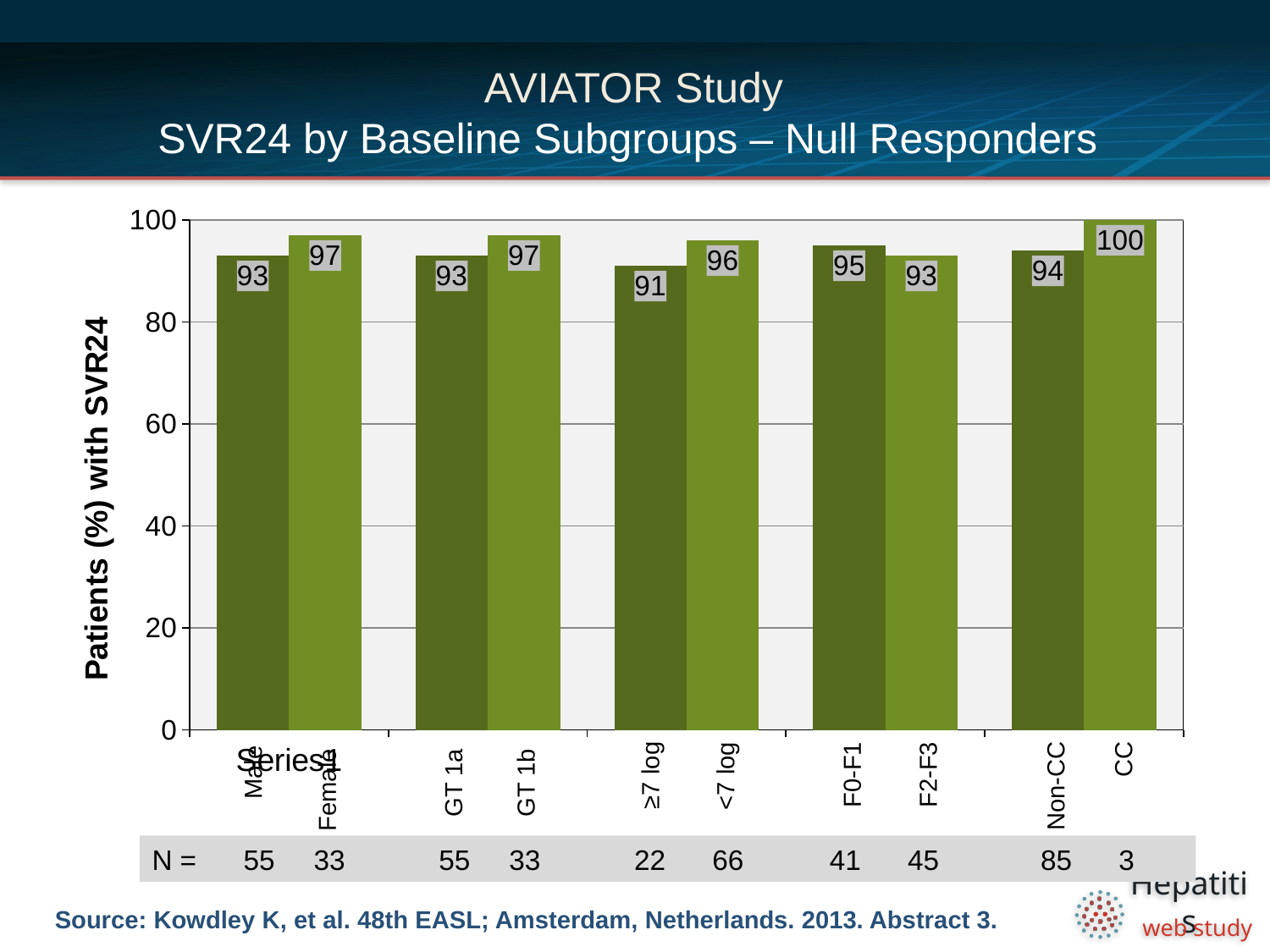
What is the SVR24 value for the <7 log subgroup? 96 What is the SVR24 value for the CC subgroup? 100 What is the label of the vertical axis? Patients (%) with SVR24 Which subgroup has the highest SVR24 value? CC What is the N value shown for the CC subgroup? 3 What is the difference between the SVR24 values for GT 1b and GT 1a? 4 What kind of chart is shown on the slide? Bar chart How many bars are plotted in the chart? 10 Which subgroup has the lowest SVR24 value? ≥7 log Which has a higher SVR24 value, F0-F1 or F2-F3? F0-F1 What is the SVR24 value for the ≥7 log subgroup? 91 Is the value for Non-CC greater or less than 80? greater